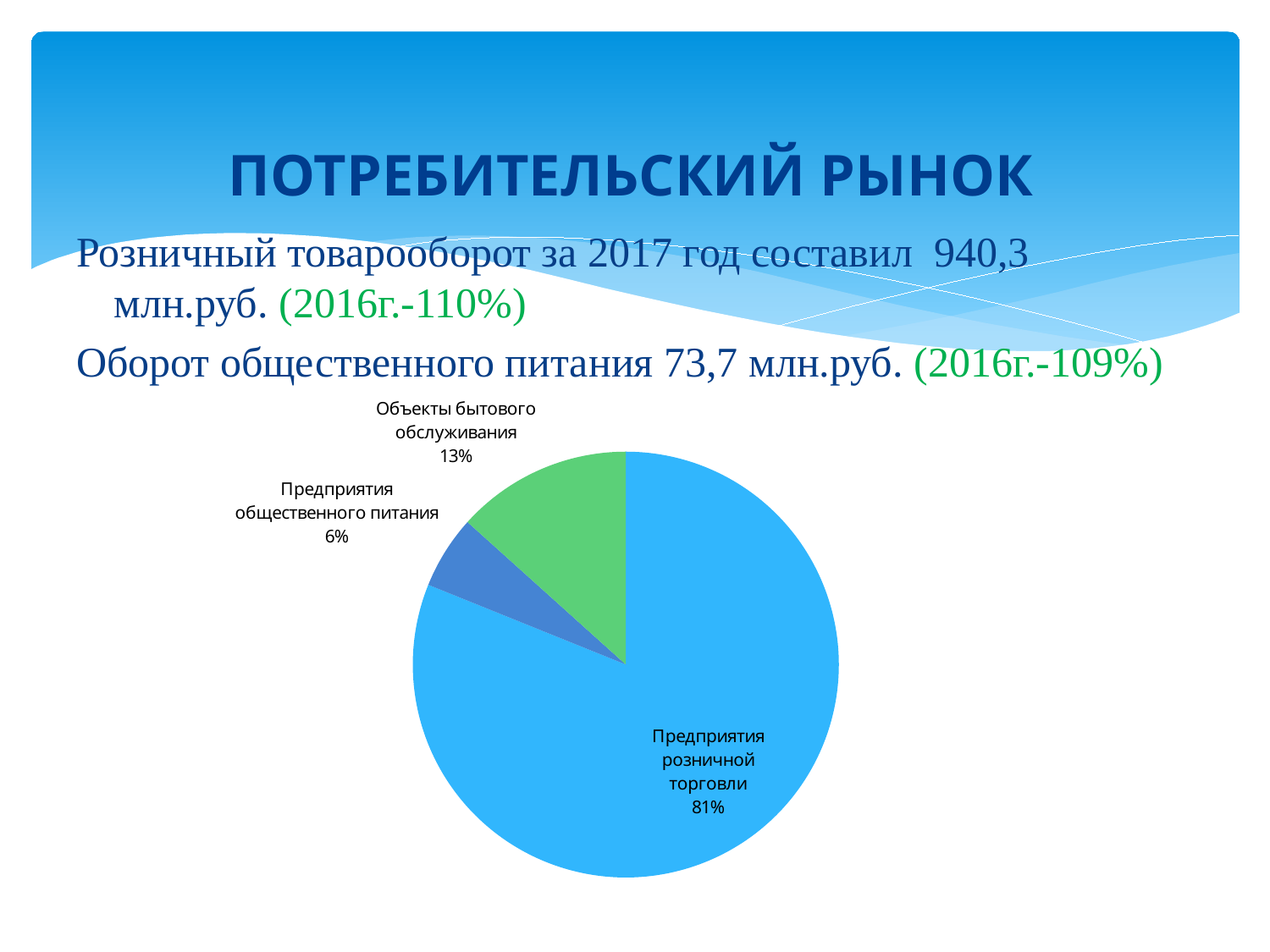
What is the difference in percentage points between Предприятия розничной торговли and Объекты бытового обслуживания? 68 What kind of chart is shown on the slide? pie chart What share of the pie does Объекты бытового обслуживания have? 13% What colour is the slice for Предприятия розничной торговли? light blue What is the difference in percentage points between Объекты бытового обслуживания and Предприятия общественного питания? 7 What colour is the slice for Объекты бытового обслуживания? green What share of the pie does Предприятия общественного питания have? 6% How many slices does the pie chart have? 3 Which category has the smallest slice of the pie? Предприятия общественного питания Which is larger: the share for Объекты бытового обслуживания or the share for Предприятия общественного питания? Объекты бытового обслуживания Which category has the largest slice of the pie? Предприятия розничной торговли What share of the pie does Предприятия розничной торговли have? 81%